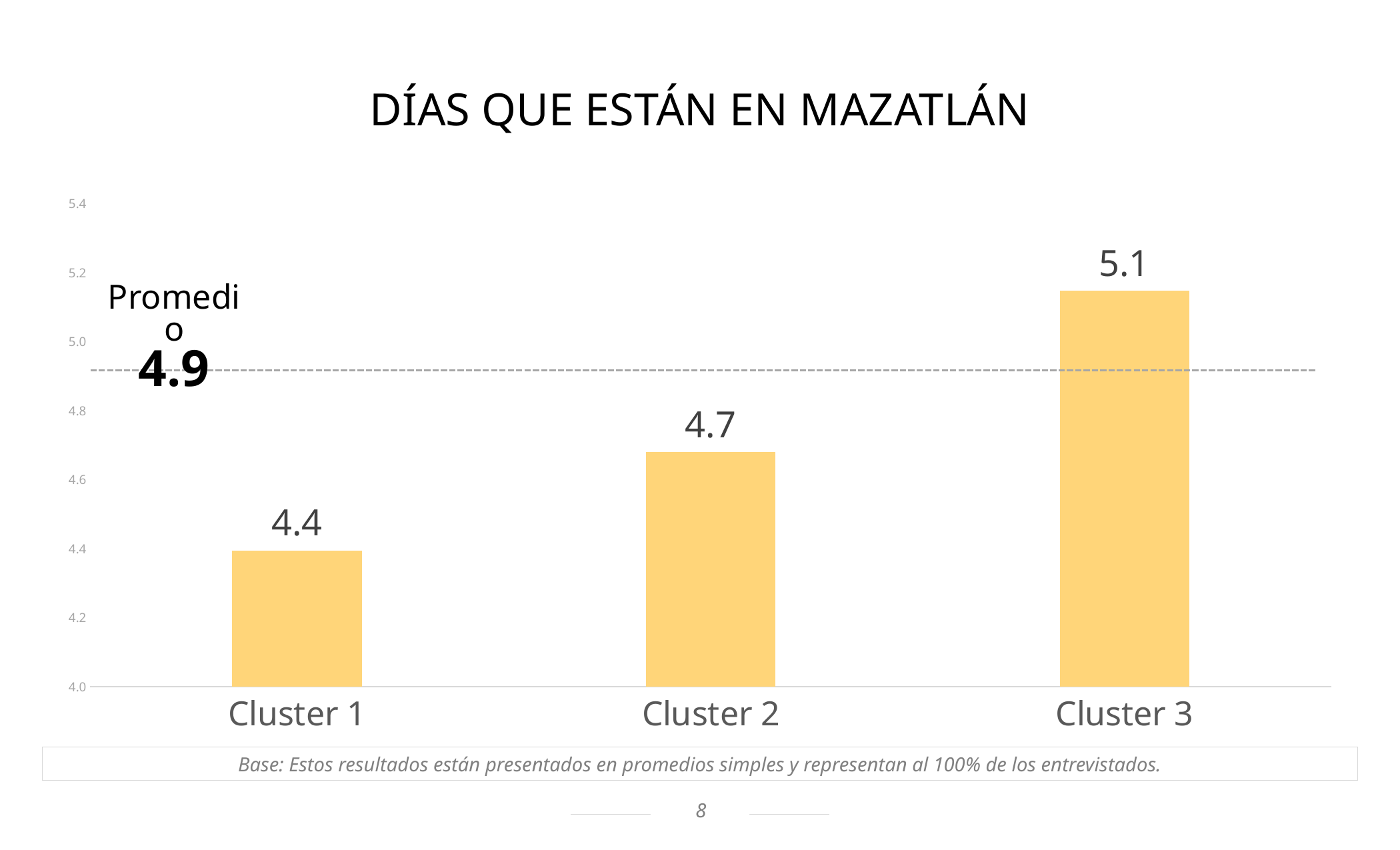
What is the value for Cluster 1? 4.4 How many clusters are shown in the chart? 3 Which cluster has the highest value? Cluster 3 What is the value for Cluster 3? 5.1 What is the average (Promedio) value marked by the dashed line? 4.9 Which cluster has the lowest value? Cluster 1 Which is larger, the value for Cluster 2 or the value for Cluster 1? Cluster 2 Is the value for Cluster 3 greater or less than 5.0? greater What kind of chart is shown on the slide? bar chart What is the value for Cluster 2? 4.7 What is the difference between the values for Cluster 3 and Cluster 1? 0.7 Do the values rise or fall from Cluster 1 to Cluster 3? rise